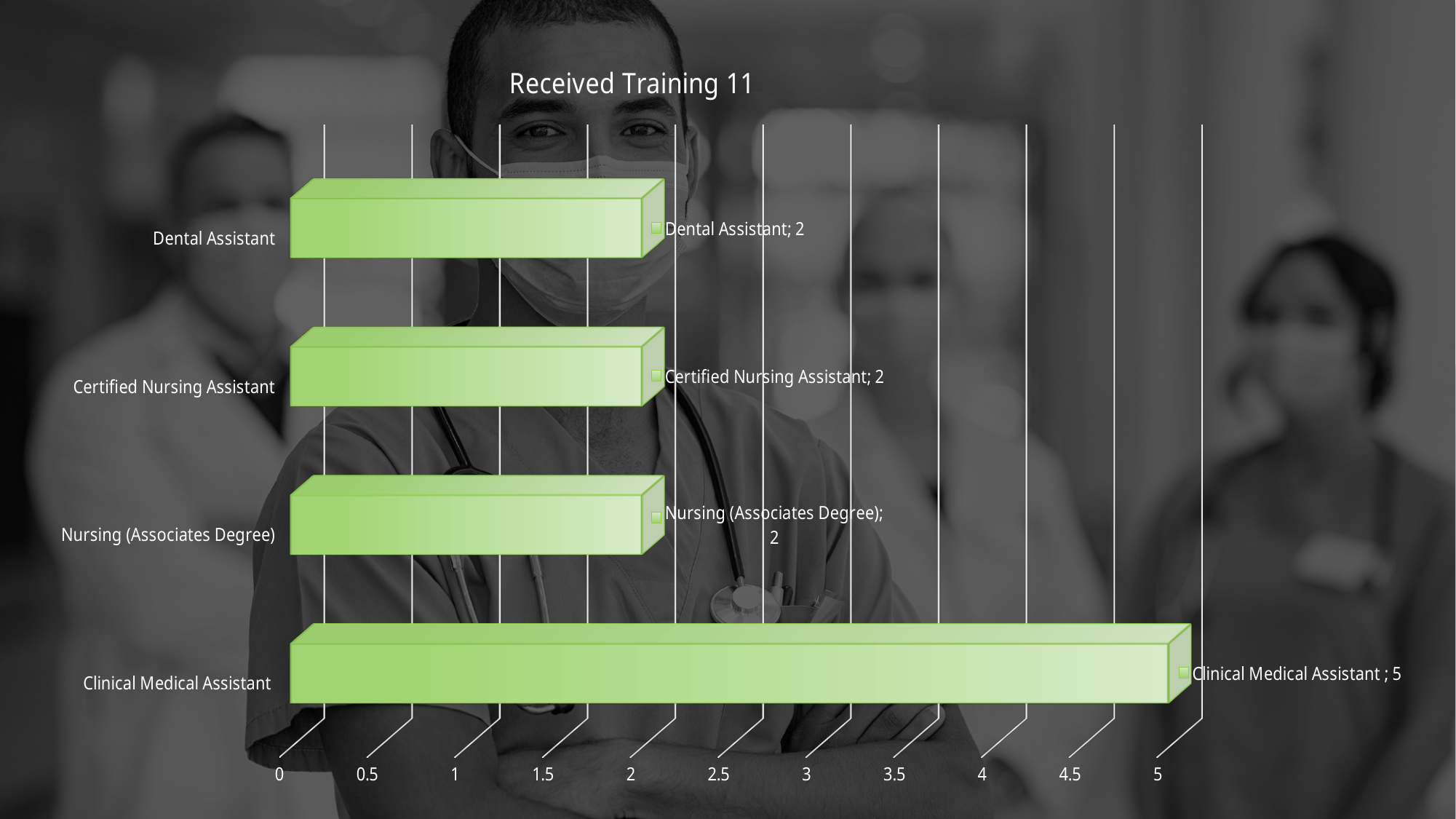
What is the difference between the values for Clinical Medical Assistant and Dental Assistant? 3 What is the value for Clinical Medical Assistant? 5 Which category has the highest value? Clinical Medical Assistant Is the value for Clinical Medical Assistant greater or less than 4? greater What is the title of the chart? Received Training 11 What is the value for Nursing (Associates Degree)? 2 Is the value for Nursing (Associates Degree) greater or less than 3? less What is the value for Certified Nursing Assistant? 2 Which is larger, the value for Clinical Medical Assistant or the value for Certified Nursing Assistant? Clinical Medical Assistant What is the value for Dental Assistant? 2 What kind of chart is shown on the slide? Bar chart How many categories are shown in the chart? 4